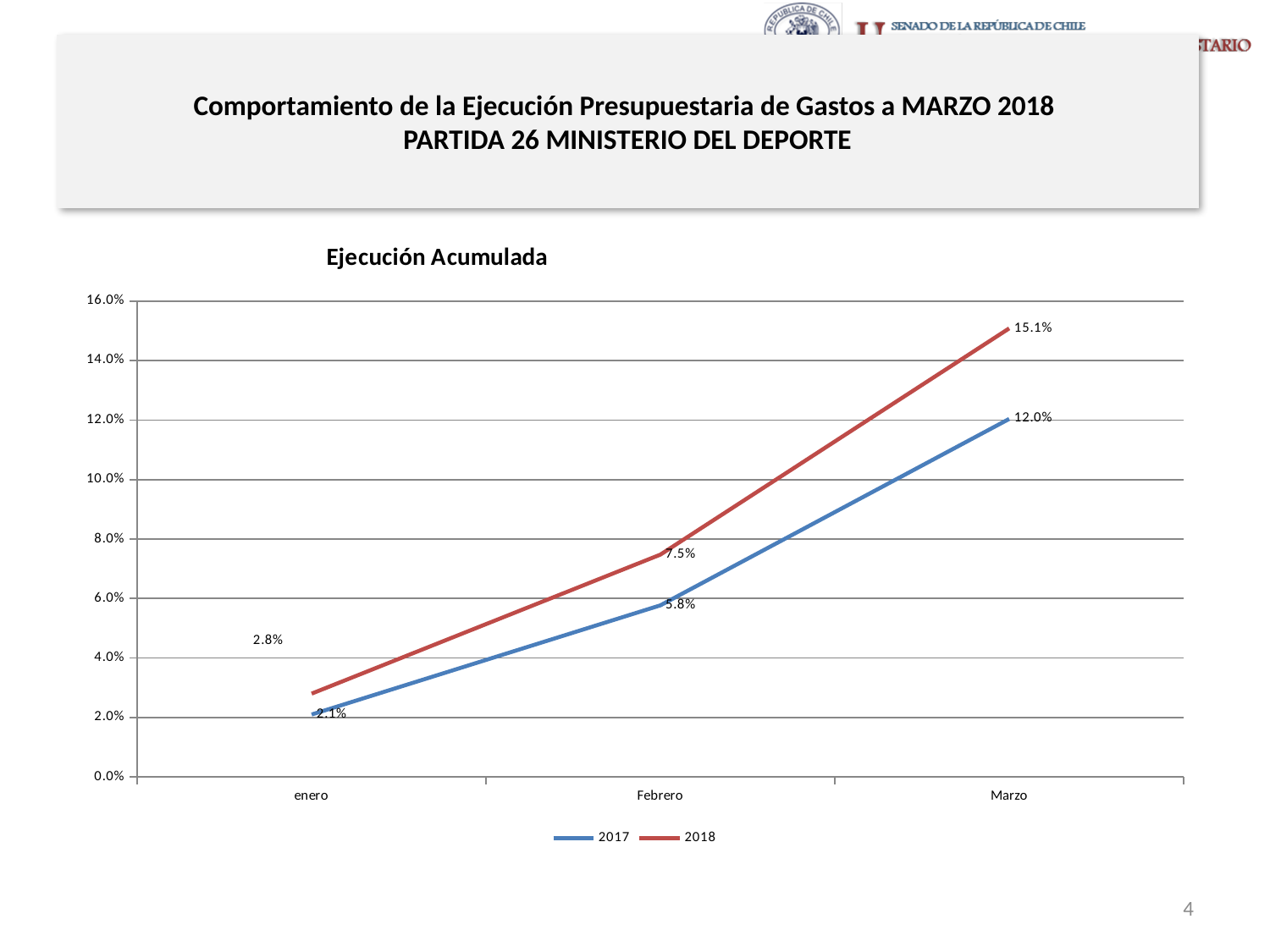
What is the value for 2017 in Marzo? 12.0% What is the value for 2017 in Febrero? 5.8% In which month does the 2018 series reach its highest value? Marzo In which month is the 2017 series lowest? enero How many months are shown on the x axis? 3 How many series does the legend list? 2 What is the value for 2018 in Marzo? 15.1% What is the value for 2018 in enero? 2.8% What is the difference between the 2018 and 2017 values in Marzo? 3.1% What kind of chart is shown? Line chart Do the values for 2017 rise or fall from enero to Marzo? Rise Which series has the higher value in Febrero, 2017 or 2018? 2018